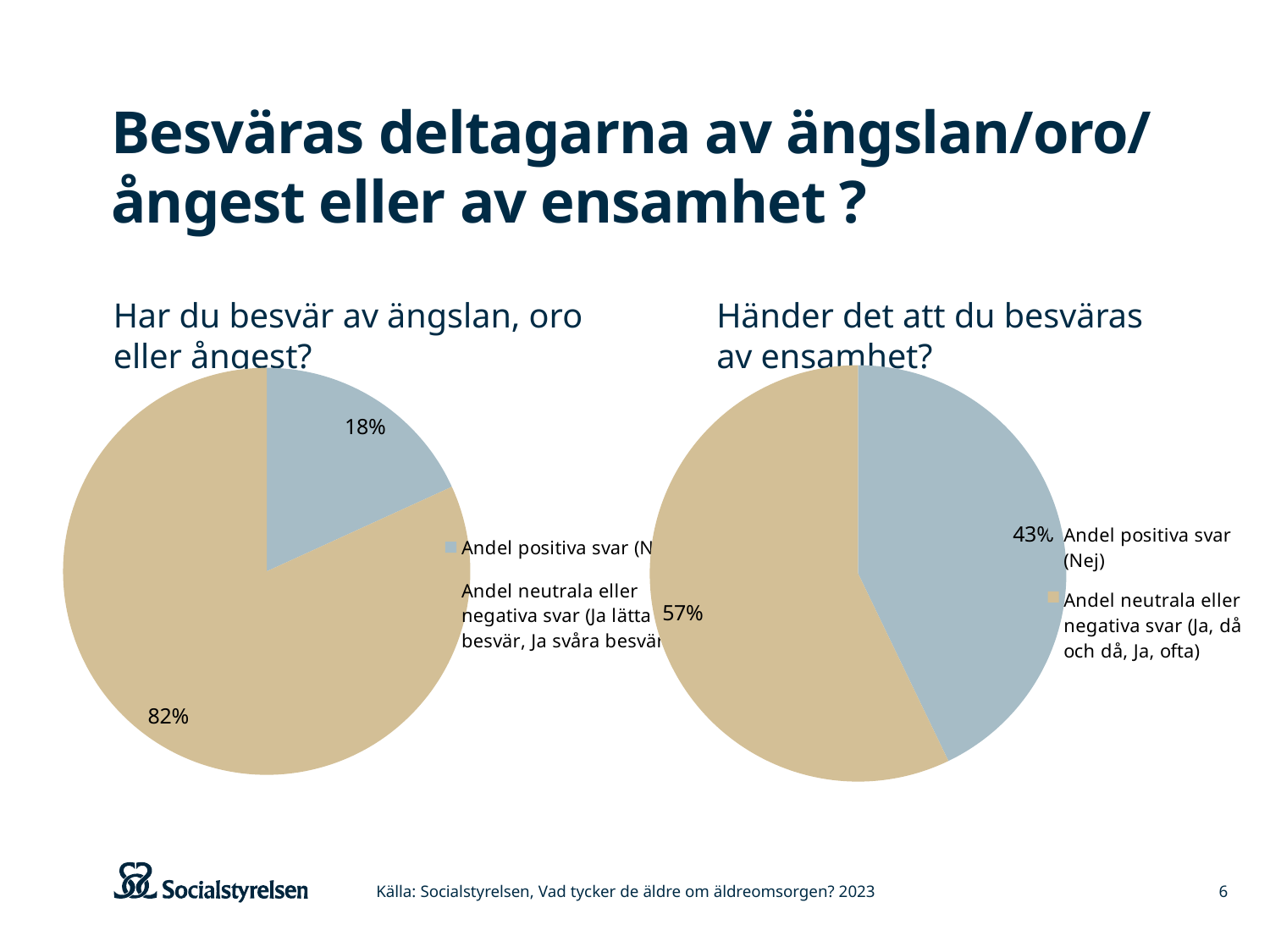
How many pie charts are shown on the slide? 2 In the left pie chart 'Har du besvär av ängslan, oro eller ångest?', which slice is the largest? Andel neutrala eller negativa svar In the left pie chart 'Har du besvär av ängslan, oro eller ångest?', what is the difference between the two slices? 64 percentage points In the left pie chart 'Har du besvär av ängslan, oro eller ångest?', what share is 'Andel positiva svar'? 18% In the left pie chart 'Har du besvär av ängslan, oro eller ångest?', what share is 'Andel neutrala eller negativa svar'? 82% How many slices does the right pie chart 'Händer det att du besväras av ensamhet?' have? 2 In the right pie chart 'Händer det att du besväras av ensamhet?', what is the difference between the two slices? 14 percentage points In the right pie chart 'Händer det att du besväras av ensamhet?', which slice is the smallest? Andel positiva svar (Nej) Which is larger: the 'Andel positiva svar' share in the left chart (ängslan, oro eller ångest) or in the right chart (ensamhet)? The right chart (ensamhet) What kind of chart is used on the slide for 'Har du besvär av ängslan, oro eller ångest?'? Pie chart In the right pie chart 'Händer det att du besväras av ensamhet?', what share is 'Andel positiva svar (Nej)'? 43%